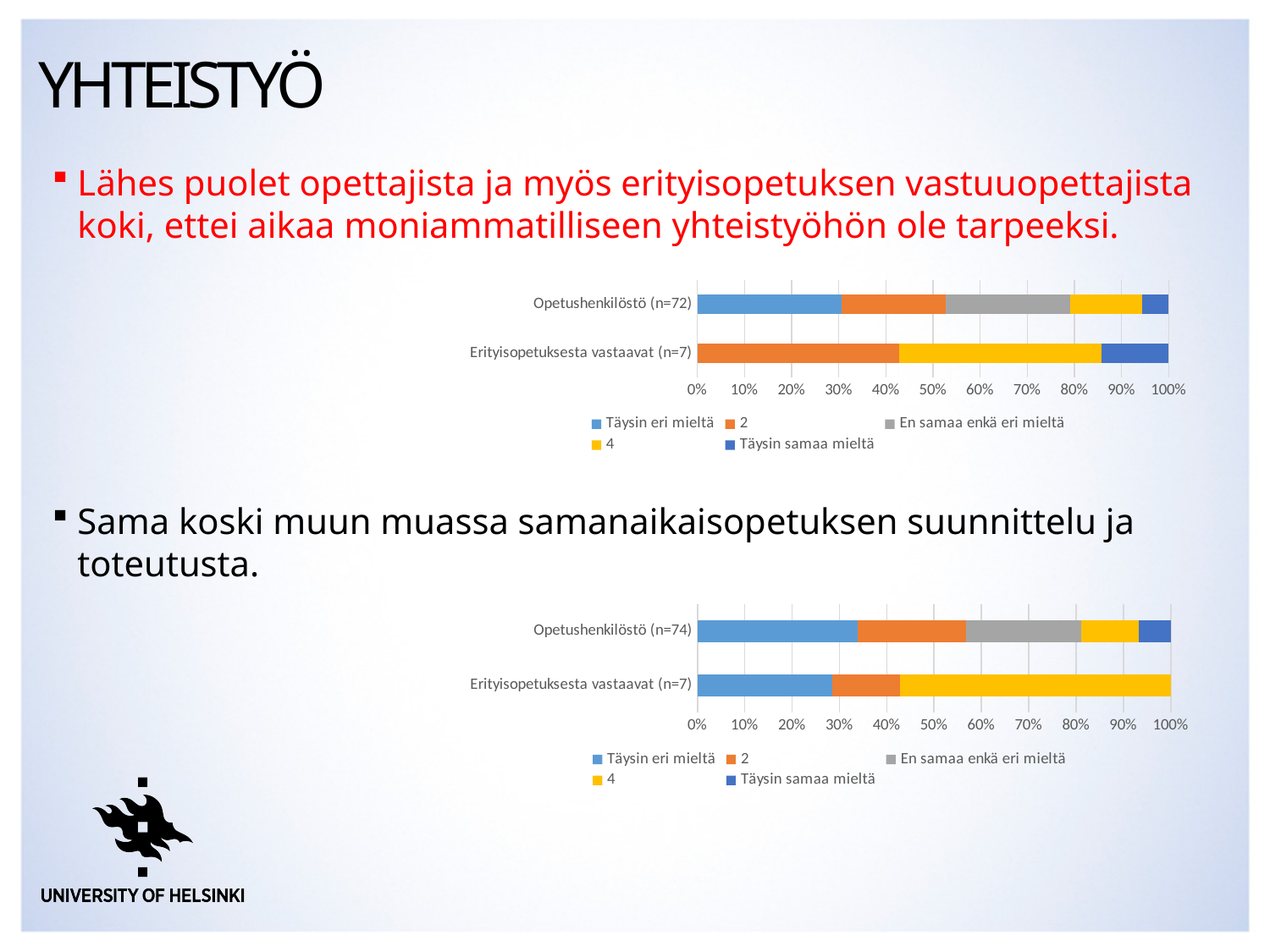
In the bottom chart, is the 'Täysin samaa mieltä' share for Opetushenkilöstö (n=74) greater or less than 10%? less In the top chart, which category has no 'Täysin eri mieltä' segment at all? Erityisopetuksesta vastaavat (n=7) In the bottom chart, for Erityisopetuksesta vastaavat (n=7), which is larger: the '4' share or the 'Täysin eri mieltä' share? 4 In the top chart, is the '4' share for Erityisopetuksesta vastaavat (n=7) greater or less than 30%? greater In the top chart, for Opetushenkilöstö (n=72), which is larger: the 'Täysin eri mieltä' share or the 'Täysin samaa mieltä' share? Täysin eri mieltä What kind of chart is the top chart on the slide? Stacked bar chart How many series does the legend of the top chart list? 5 In the top chart, is the 'Täysin samaa mieltä' share for Opetushenkilöstö (n=72) greater or less than 10%? less How many categories (bars) does the bottom chart show? 2 What is the label of the first category in the bottom chart? Opetushenkilöstö (n=74)